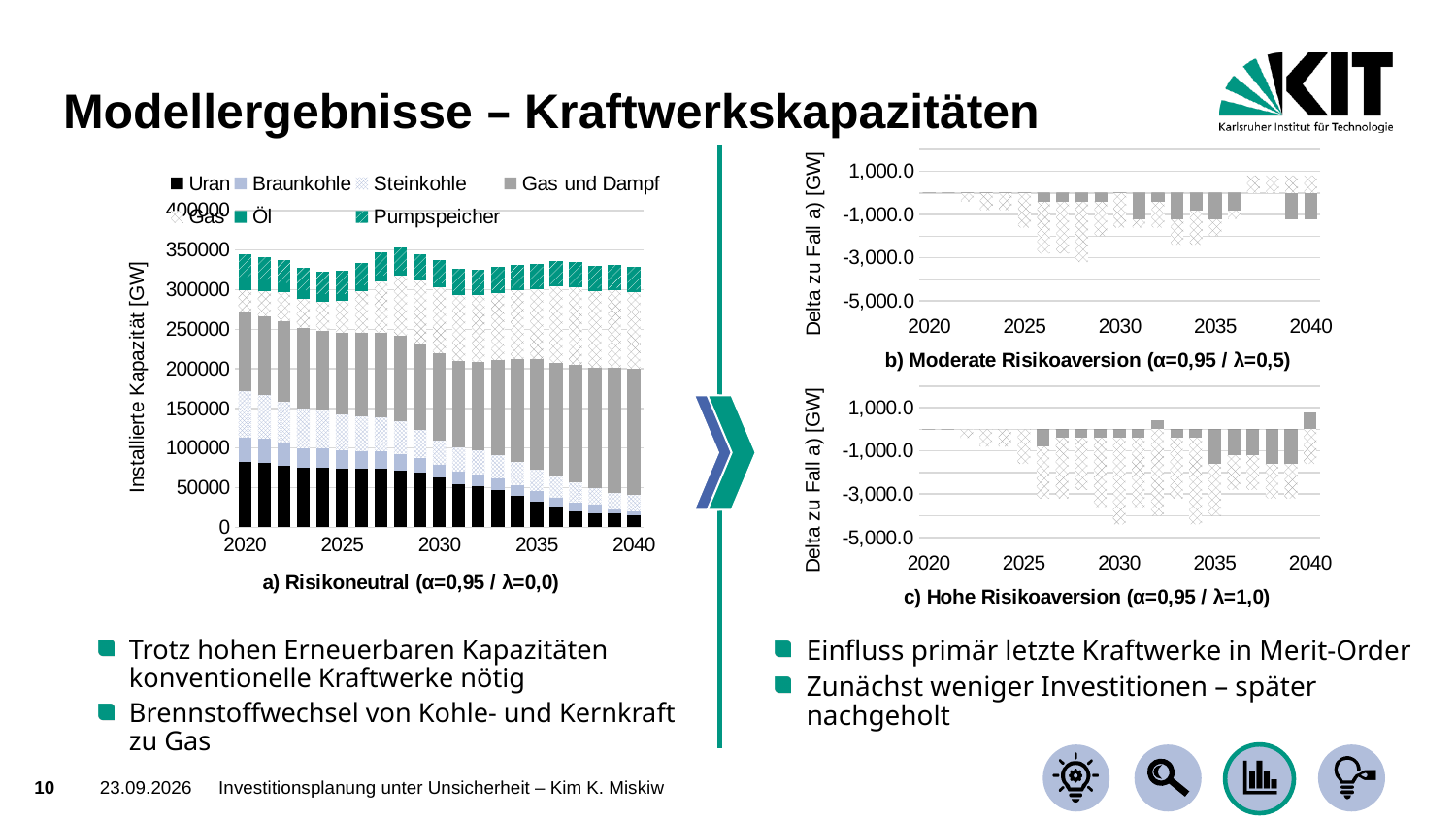
How many series does the legend of chart a) Risikoneutral list? 7 In chart a) Risikoneutral, is the value for Uran in 2020 greater or less than 50000? greater What is the y-axis label of chart a) Risikoneutral? Installierte Kapazität [GW] What kind of chart is chart b) Moderate Risikoaversion? bar chart In chart a) Risikoneutral, is the value for Uran in 2035 greater or less than 50000? less In chart a) Risikoneutral, which series is larger in 2020, Uran or Braunkohle? Uran In chart a) Risikoneutral, does the Uran series rise or fall from 2020 to 2040? fall What is the title of the bottom-right chart? c) Hohe Risikoaversion (α=0,95 / λ=1,0) In chart a) Risikoneutral, is the value for Uran in 2040 greater or less than 50000? less What kind of chart is chart a) Risikoneutral? stacked bar chart